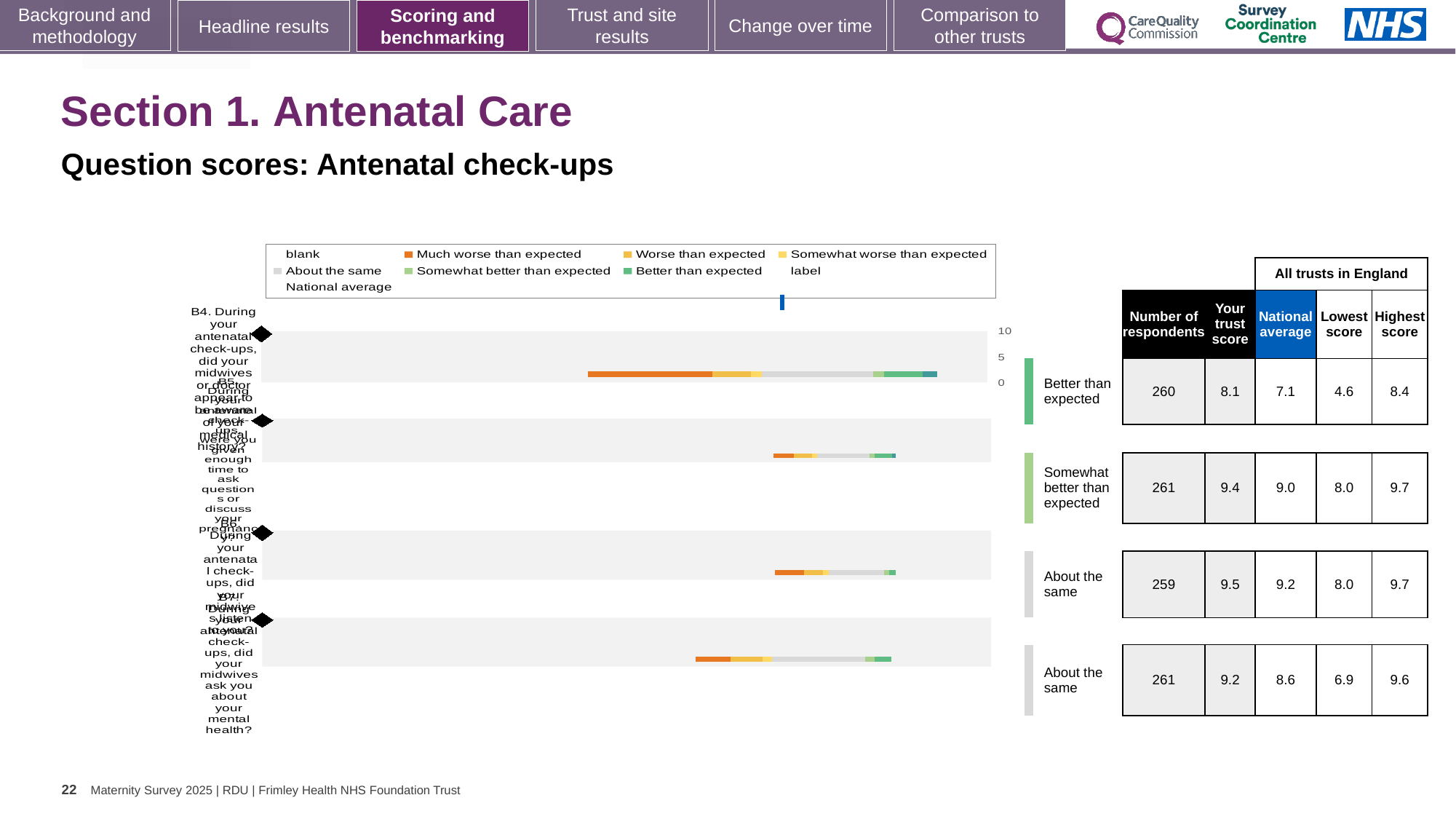
What kind of chart is used to show the question scores for antenatal check-ups? bar chart In the table beside the chart, what is the national average for the row labelled 'Somewhat better than expected'? 9.0 How many question bars (B4 to B7) are plotted in the chart? 4 In the table beside the chart, what is the lowest score for the last row (fourth row, 'About the same')? 6.9 In the table beside the chart, what is the difference between the trust score and the national average for the row labelled 'Better than expected'? 1.0 In the table beside the chart, what is the trust score for the row labelled 'Better than expected'? 8.1 In the table beside the chart, which row has the lowest number of respondents? the third row ('About the same'), 259 In the chart legend, which colour represents 'Much worse than expected'? orange In the table beside the chart, what is the highest score for the third row ('About the same')? 9.7 In the table beside the chart, which row has the highest trust score? the third row ('About the same'), 9.5 In the table beside the chart, what is the number of respondents for the first row, labelled 'Better than expected'? 260 In the table beside the chart, is the trust score for the row labelled 'Somewhat better than expected' larger or smaller than its national average? larger